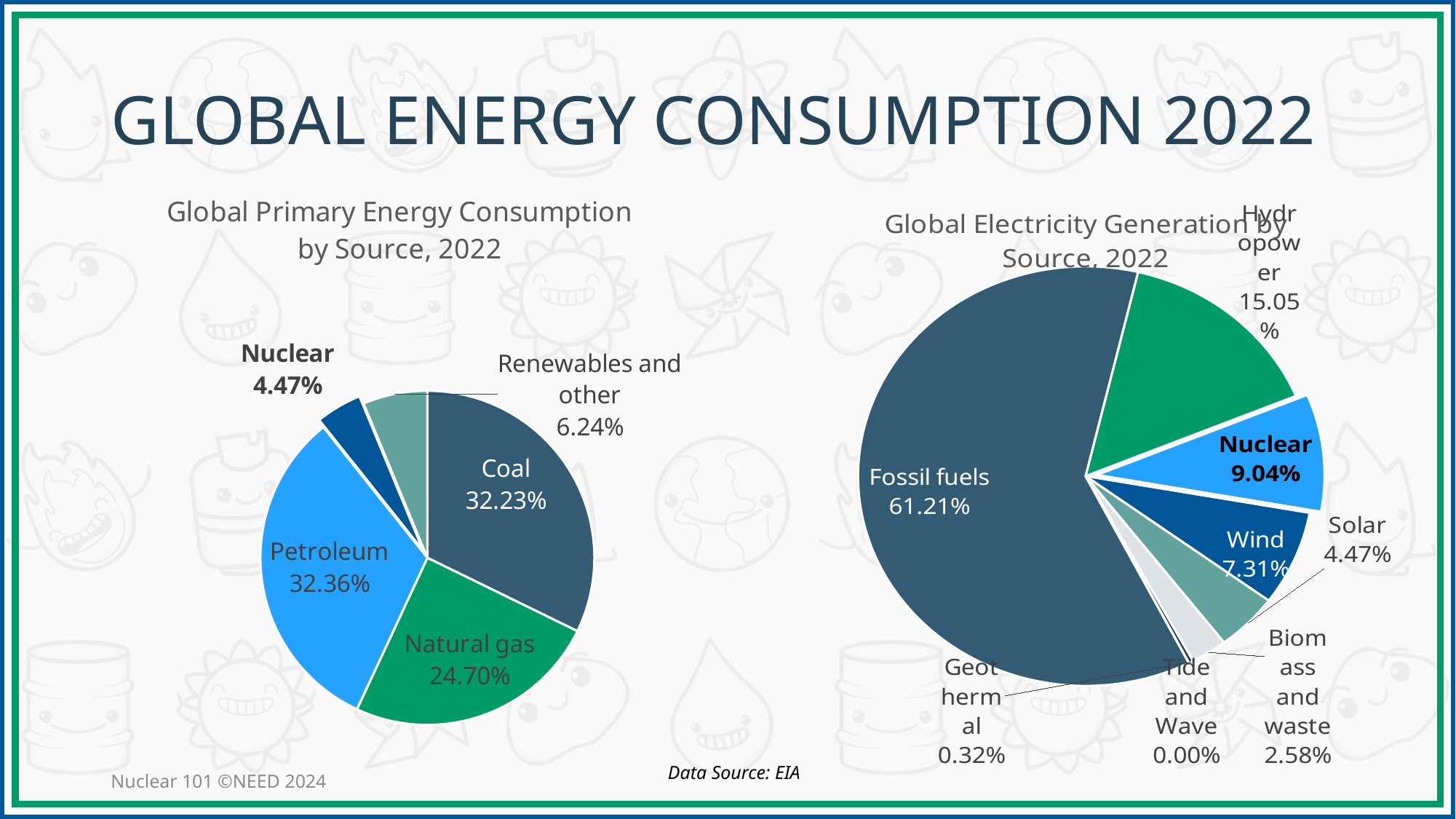
In the Global Electricity Generation by Source, 2022 chart, what is the difference between the Hydropower and Nuclear shares? 6.01% In the Global Electricity Generation by Source, 2022 chart, which source has the smallest share? Tide and Wave In the Global Electricity Generation by Source, 2022 chart, which is larger, Wind or Solar? Wind In the Global Electricity Generation by Source, 2022 chart, what share does Nuclear have? 9.04% In the Global Primary Energy Consumption by Source, 2022 chart, what share does Nuclear have? 4.47% In the Global Primary Energy Consumption by Source, 2022 chart, which source has the smallest share? Nuclear What type of chart is used for the Global Electricity Generation by Source, 2022 chart? Pie chart In the Global Primary Energy Consumption by Source, 2022 chart, how many sources are shown? 5 In the Global Primary Energy Consumption by Source, 2022 chart, what is the difference between the Petroleum and Natural gas shares? 7.66% In the Global Primary Energy Consumption by Source, 2022 chart, what share does Coal have? 32.23% In the Global Electricity Generation by Source, 2022 chart, which source has the largest share? Fossil fuels In the Global Electricity Generation by Source, 2022 chart, what share does Fossil fuels have? 61.21%